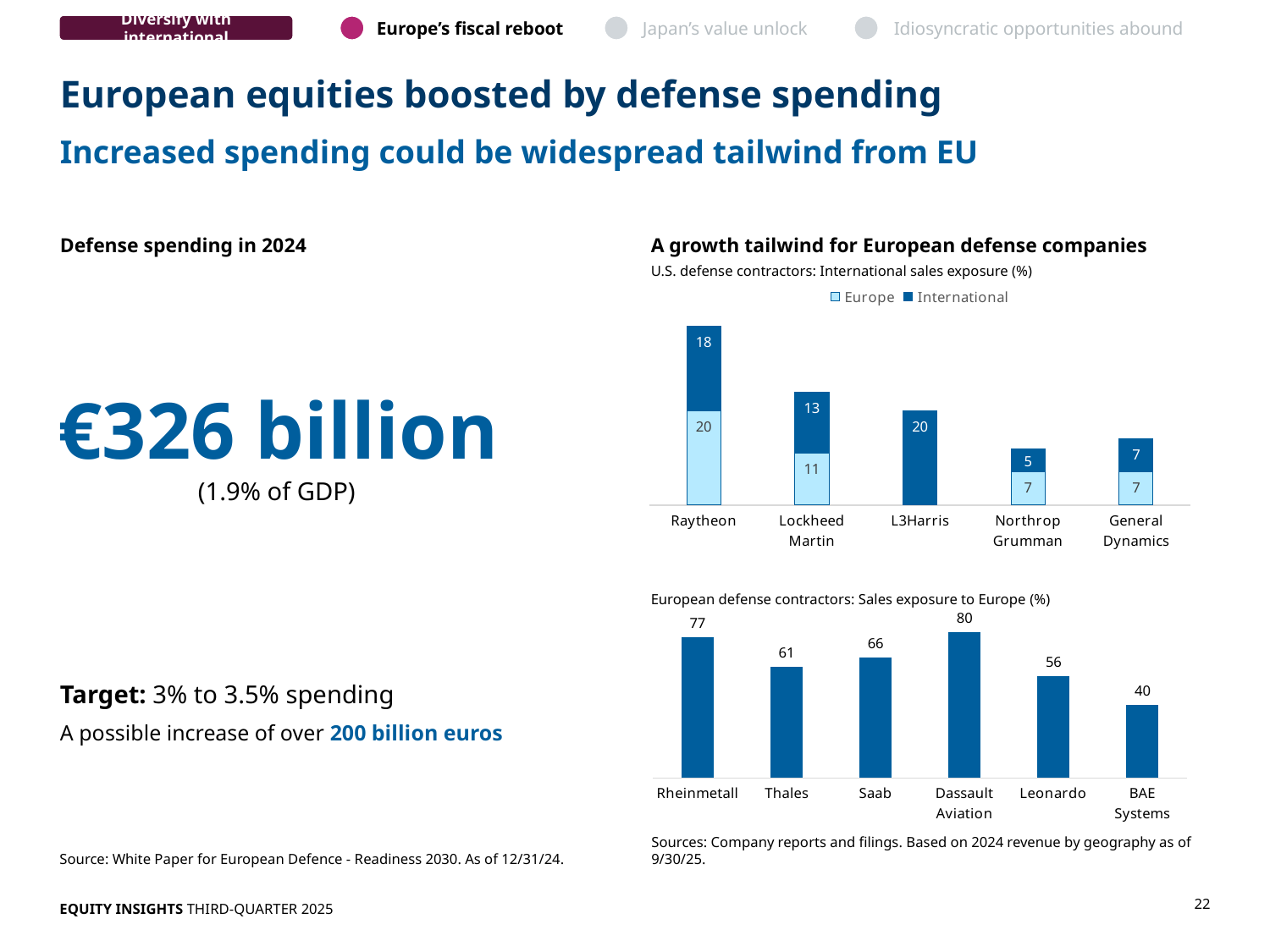
In the European defense contractors chart, which company has the highest sales exposure to Europe? Dassault Aviation What type of chart is the European defense contractors chart? Bar chart In the European defense contractors chart, which company has the lowest sales exposure to Europe? BAE Systems In the European defense contractors chart, what is the value for Saab? 66 In the European defense contractors chart, which is larger, Leonardo or Saab? Saab How many companies are shown in the U.S. defense contractors chart? 5 In the European defense contractors chart, what is the difference between Rheinmetall and Thales? 16 In the U.S. defense contractors chart, what is the International value for Lockheed Martin? 13 In the U.S. defense contractors chart, what is the Europe value for Raytheon? 20 How many series does the legend of the U.S. defense contractors chart list? 2 In the U.S. defense contractors chart, what is the total of the stacked bar for Raytheon? 38 In the U.S. defense contractors chart, what is the total of the stacked bar for Northrop Grumman? 12